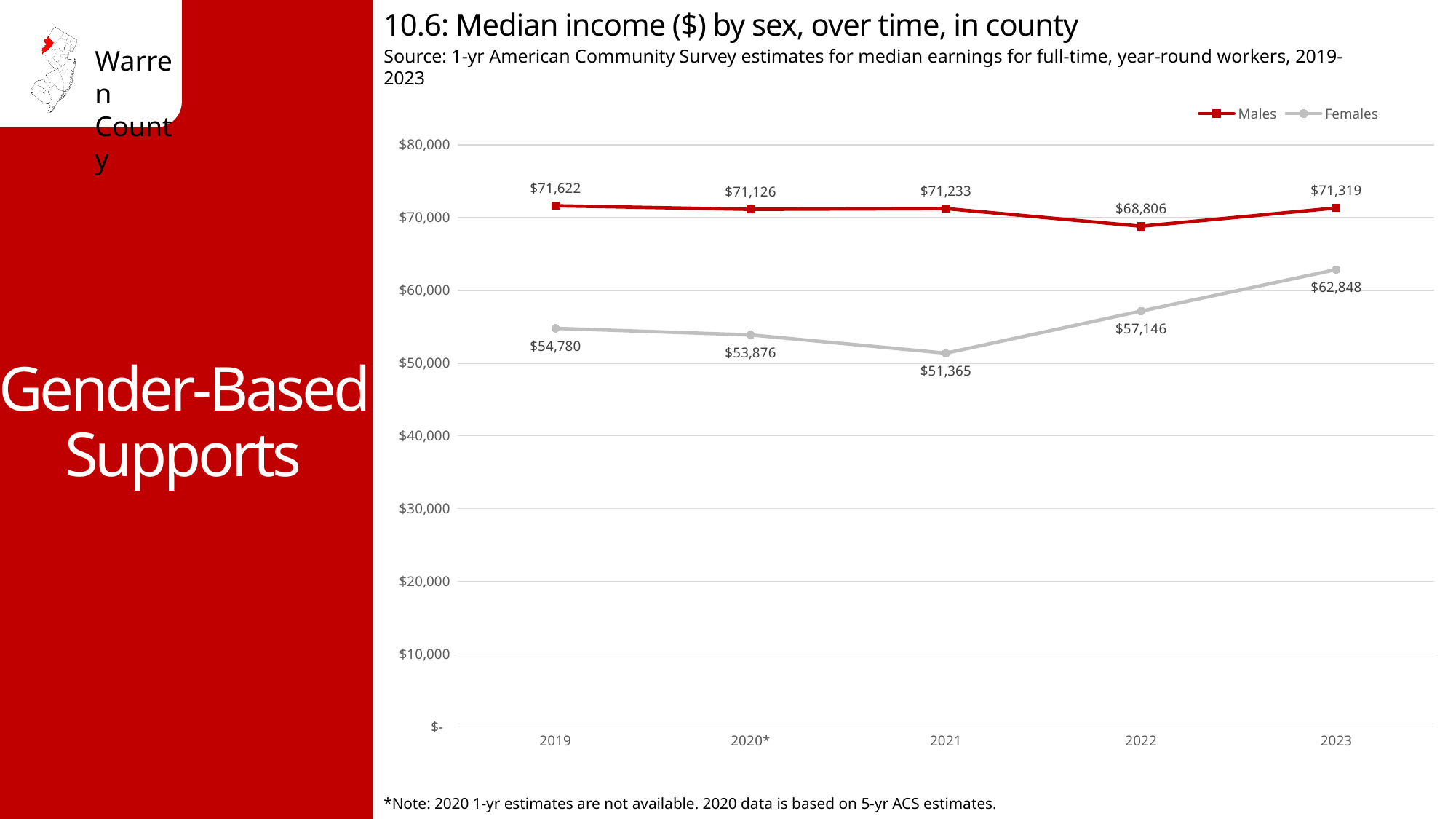
What was the median income for males in 2022? $68,806 How many years are shown on the x axis? 5 How many series does the legend list? 2 What was the median income for females in 2021? $51,365 In which year was the median income for males lowest? 2022 What was the median income for males in 2019? $71,622 What kind of chart is shown on the slide? Line chart What is the difference between male and female median income in 2023? $8,471 In which year was the median income for females lowest? 2021 In which year was the median income for females highest? 2023 Which was higher in 2020*, the median income for males or for females? Males What was the median income for females in 2023? $62,848